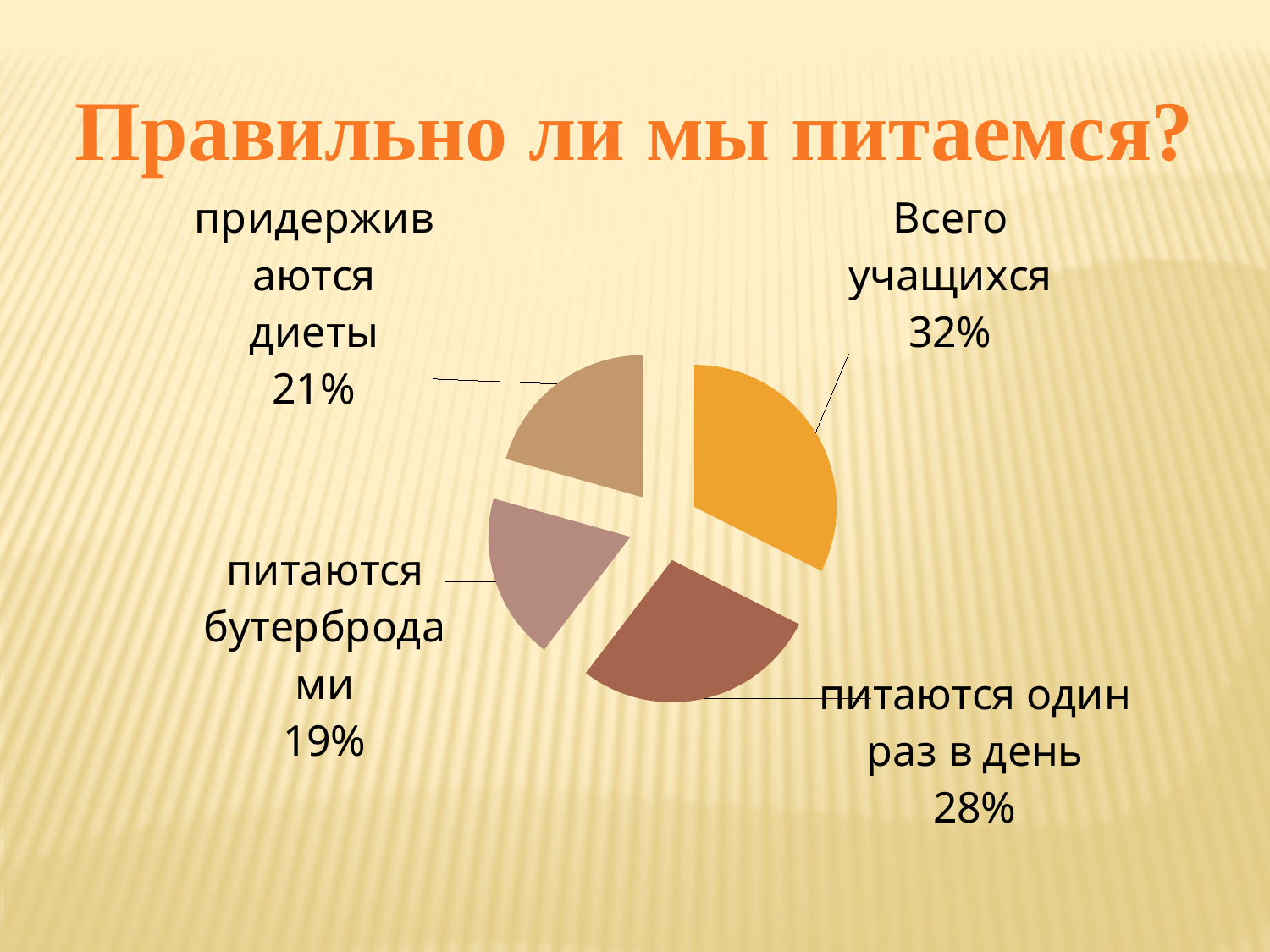
What percentage is shown for "придерживаются диеты"? 21% What percentage is shown for "питаются бутербродами"? 19% What kind of chart is shown on the slide? Pie chart How many slices does the pie chart have? 4 Which slice of the pie chart has the largest share? Всего учащихся What percentage is shown for "питаются один раз в день"? 28% Which is larger: the share for "придерживаются диеты" or the share for "питаются один раз в день"? питаются один раз в день What is the title of the slide containing the pie chart? Правильно ли мы питаемся? What percentage is shown for "Всего учащихся"? 32% What is the difference in percentage points between "Всего учащихся" and "питаются бутербродами"? 13 Which slice of the pie chart has the smallest share? питаются бутербродами What is the difference in percentage points between "питаются один раз в день" and "придерживаются диеты"? 7